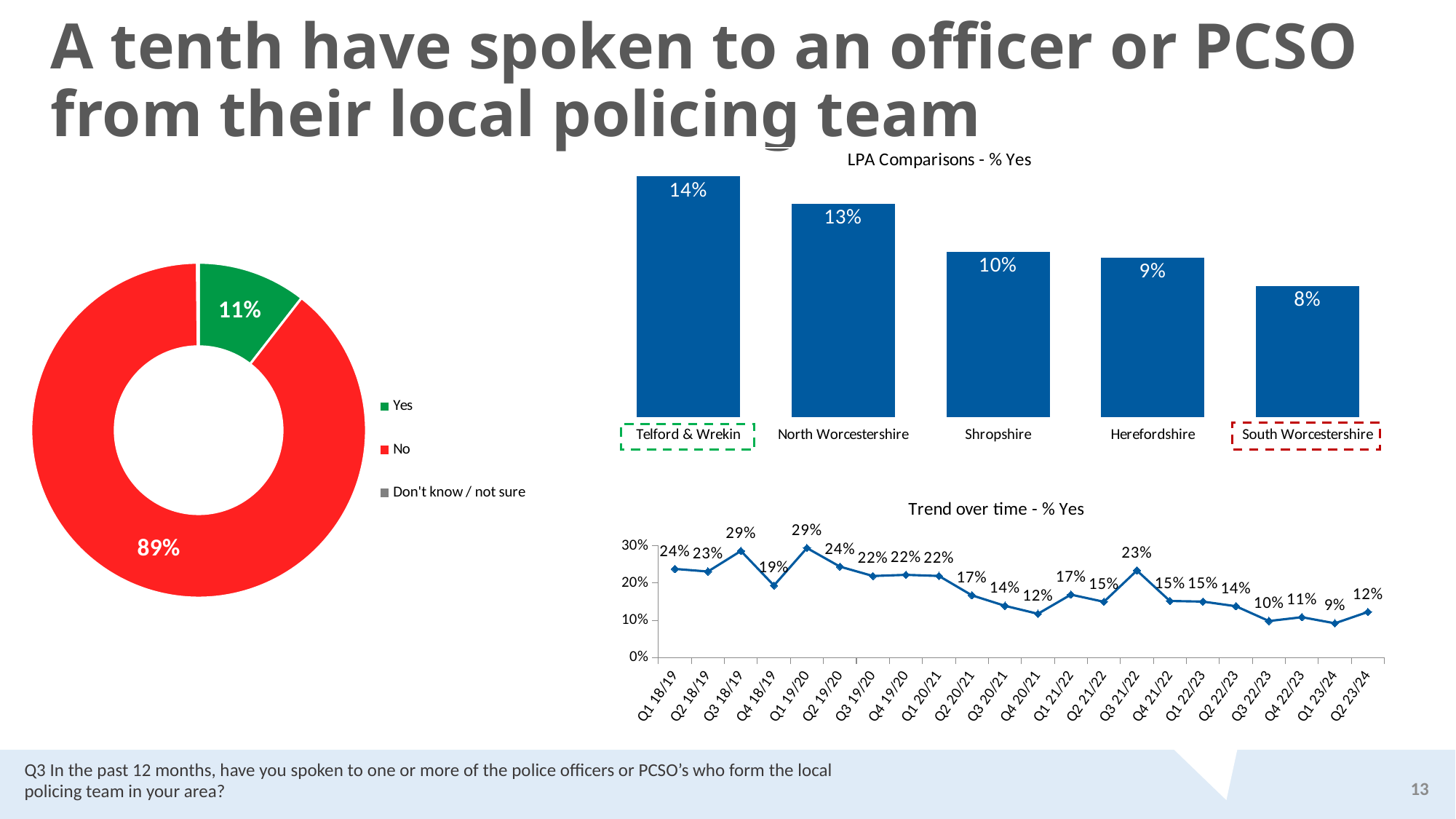
In the Trend over time - % Yes chart, do the values generally rise or fall from Q1 18/19 to Q2 23/24? Fall In the LPA Comparisons - % Yes chart, what is the difference between Telford & Wrekin and South Worcestershire? 6 percentage points In the Trend over time - % Yes chart, what is the value for Q3 21/22? 23% In the donut chart on the left, what is the value for No? 89% In the LPA Comparisons - % Yes chart, what is the value for Shropshire? 10% In the LPA Comparisons - % Yes chart, which area has the lowest value? South Worcestershire How many entries does the legend of the donut chart on the left list? 3 In the LPA Comparisons - % Yes chart, how many areas are shown? 5 What kind of chart is the Trend over time - % Yes chart? Line chart In the LPA Comparisons - % Yes chart, which area has the highest value? Telford & Wrekin In the donut chart on the left, what share of respondents answered Yes? 11% In the Trend over time - % Yes chart, which quarter has the lowest value? Q1 23/24